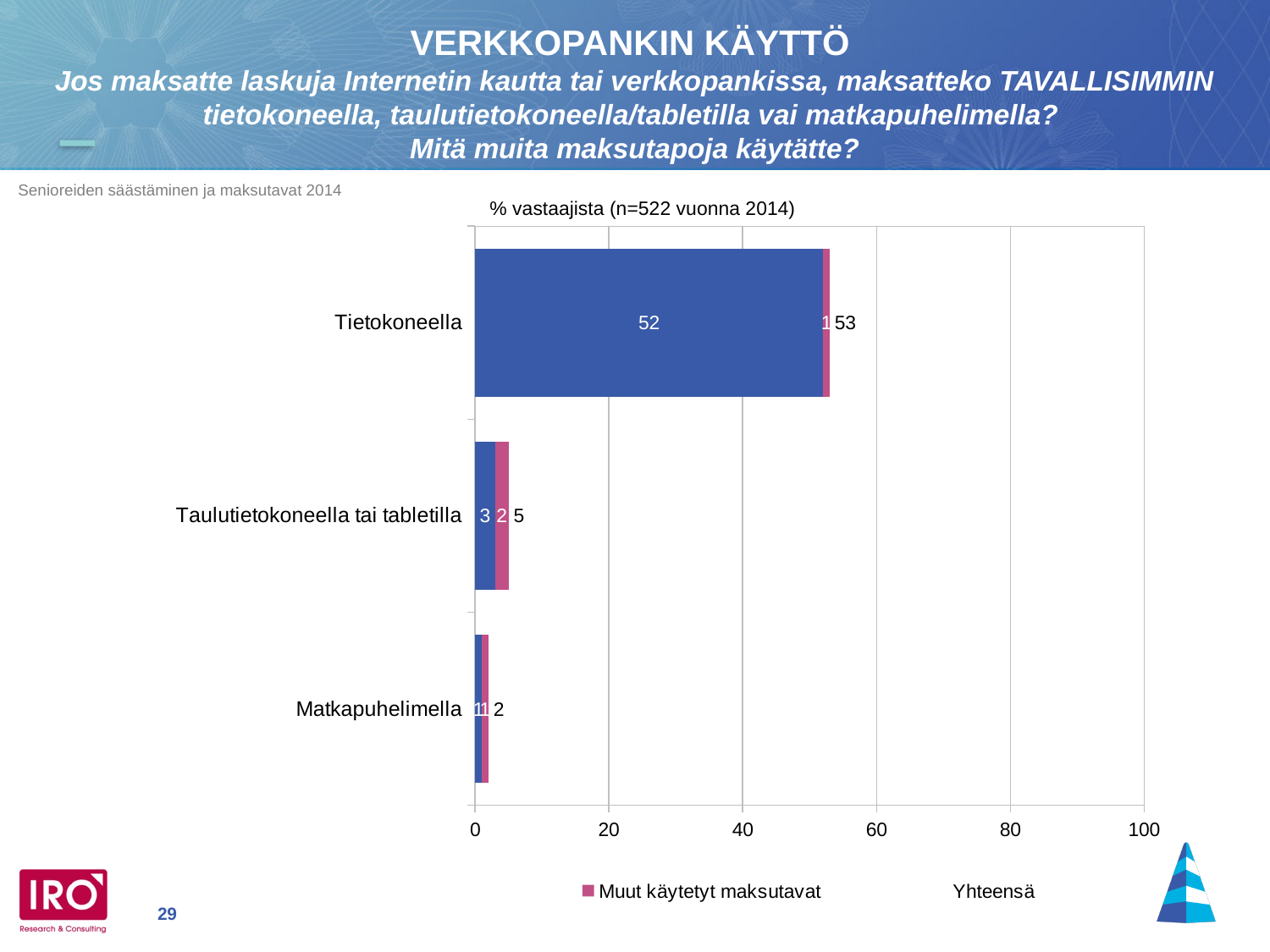
What is the difference between the total for Tietokoneella and the total for Taulutietokoneella tai tabletilla? 48 What is the total (Yhteensä) value for Tietokoneella? 53 How many categories are shown on the y axis of the chart? 3 What is the Muut käytetyt maksutavat value for Taulutietokoneella tai tabletilla? 2 What kind of chart is shown on the slide? bar chart What is the Muut käytetyt maksutavat value for Tietokoneella? 1 Which category has the highest total value? Tietokoneella Which category has the lowest total value? Matkapuhelimella What is the total (Yhteensä) value for Matkapuhelimella? 2 Which has a larger total value, Taulutietokoneella tai tabletilla or Matkapuhelimella? Taulutietokoneella tai tabletilla What is the total (Yhteensä) value for Taulutietokoneella tai tabletilla? 5 What is the title printed above the chart? % vastaajista (n=522 vuonna 2014)